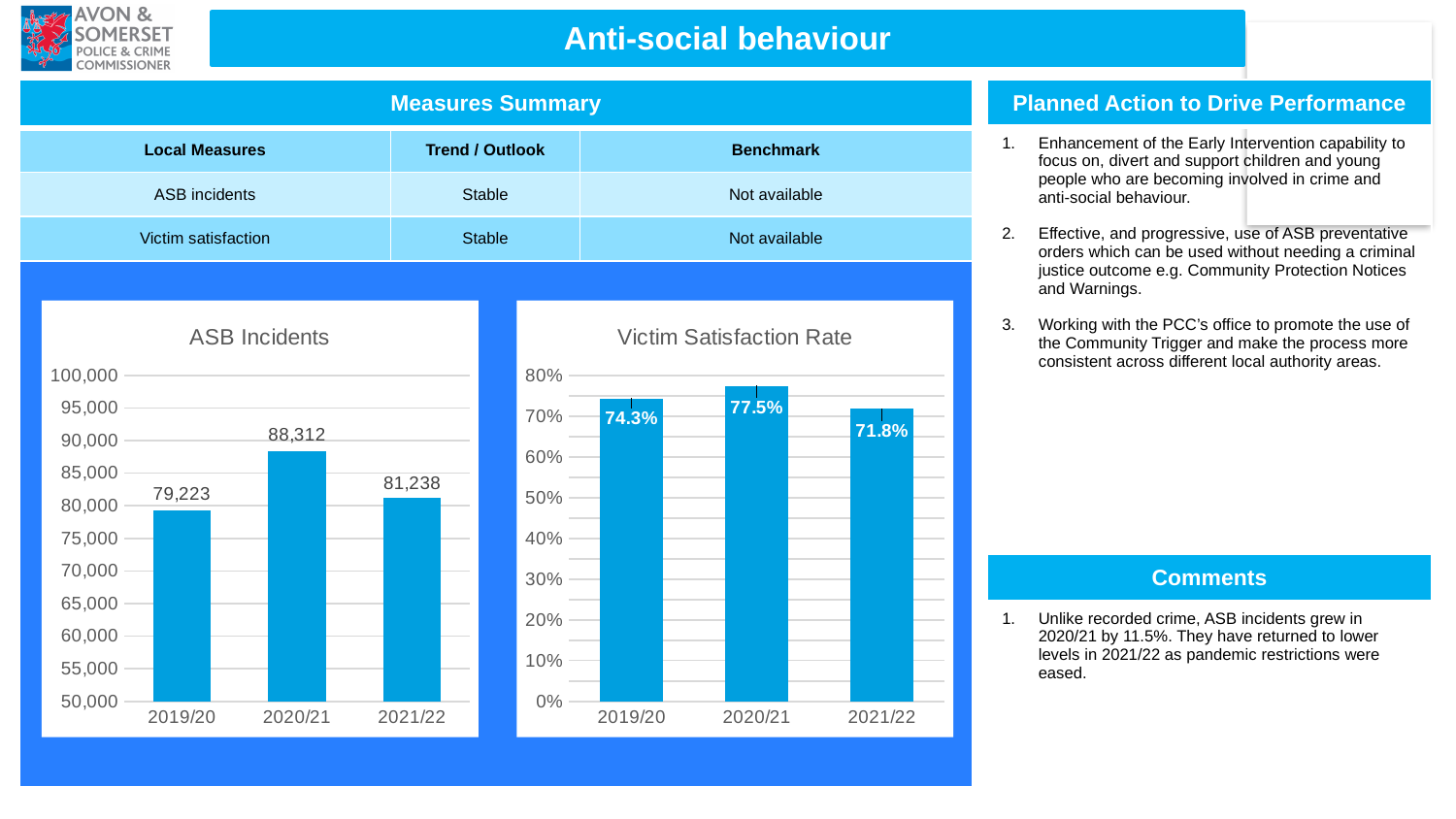
In the ASB Incidents chart, is the value for 2021/22 greater or less than 80,000? greater How many categories are shown on the x axis of the Victim Satisfaction Rate chart? 3 In the Victim Satisfaction Rate chart, what is the value for 2020/21? 77.5% In the Victim Satisfaction Rate chart, what is the value for 2021/22? 71.8% In the ASB Incidents chart, which year has the highest value? 2020/21 In the ASB Incidents chart, which year has the lowest value? 2019/20 In the ASB Incidents chart, what is the value for 2020/21? 88,312 In the Victim Satisfaction Rate chart, which is larger, the value for 2019/20 or 2021/22? 2019/20 In the ASB Incidents chart, what is the value for 2019/20? 79,223 What kind of chart is the ASB Incidents chart? bar chart In the Victim Satisfaction Rate chart, which year has the lowest value? 2021/22 In the ASB Incidents chart, what is the difference between the 2020/21 and 2021/22 values? 7,074